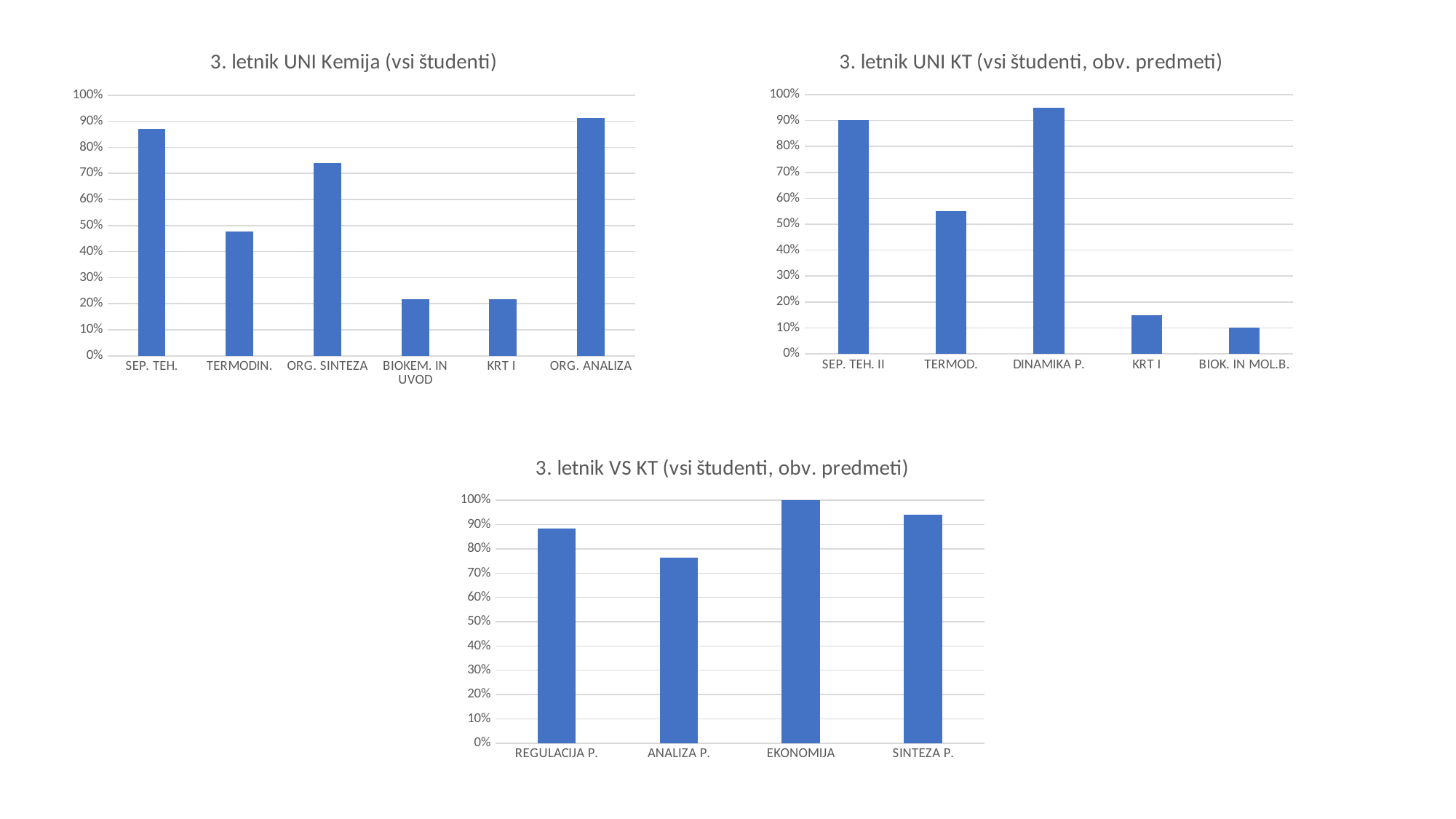
In the chart titled "3. letnik UNI Kemija (vsi študenti)", which category has the highest value? ORG. ANALIZA In the chart titled "3. letnik UNI KT (vsi študenti, obv. predmeti)", which category has the lowest value? BIOK. IN MOL.B. How many categories are shown in the chart titled "3. letnik UNI Kemija (vsi študenti)"? 6 In the chart titled "3. letnik UNI KT (vsi študenti, obv. predmeti)", which category has the highest value? DINAMIKA P. In the chart titled "3. letnik VS KT (vsi študenti, obv. predmeti)", what is the value for EKONOMIJA? 100% In the chart titled "3. letnik UNI Kemija (vsi študenti)", is the value for ORG. SINTEZA greater or less than 70%? greater In the chart titled "3. letnik UNI Kemija (vsi študenti)", is the value for TERMODIN. greater or less than 50%? less In the chart titled "3. letnik VS KT (vsi študenti, obv. predmeti)", which category has the lowest value? ANALIZA P. What kind of chart is the chart titled "3. letnik UNI KT (vsi študenti, obv. predmeti)"? bar chart In the chart titled "3. letnik UNI KT (vsi študenti, obv. predmeti)", is the value for KRT I greater or less than 20%? less In the chart titled "3. letnik VS KT (vsi študenti, obv. predmeti)", which is larger, the value for REGULACIJA P. or the value for ANALIZA P.? REGULACIJA P. In the chart titled "3. letnik UNI Kemija (vsi študenti)", which is larger, the value for SEP. TEH. or the value for ORG. SINTEZA? SEP. TEH.